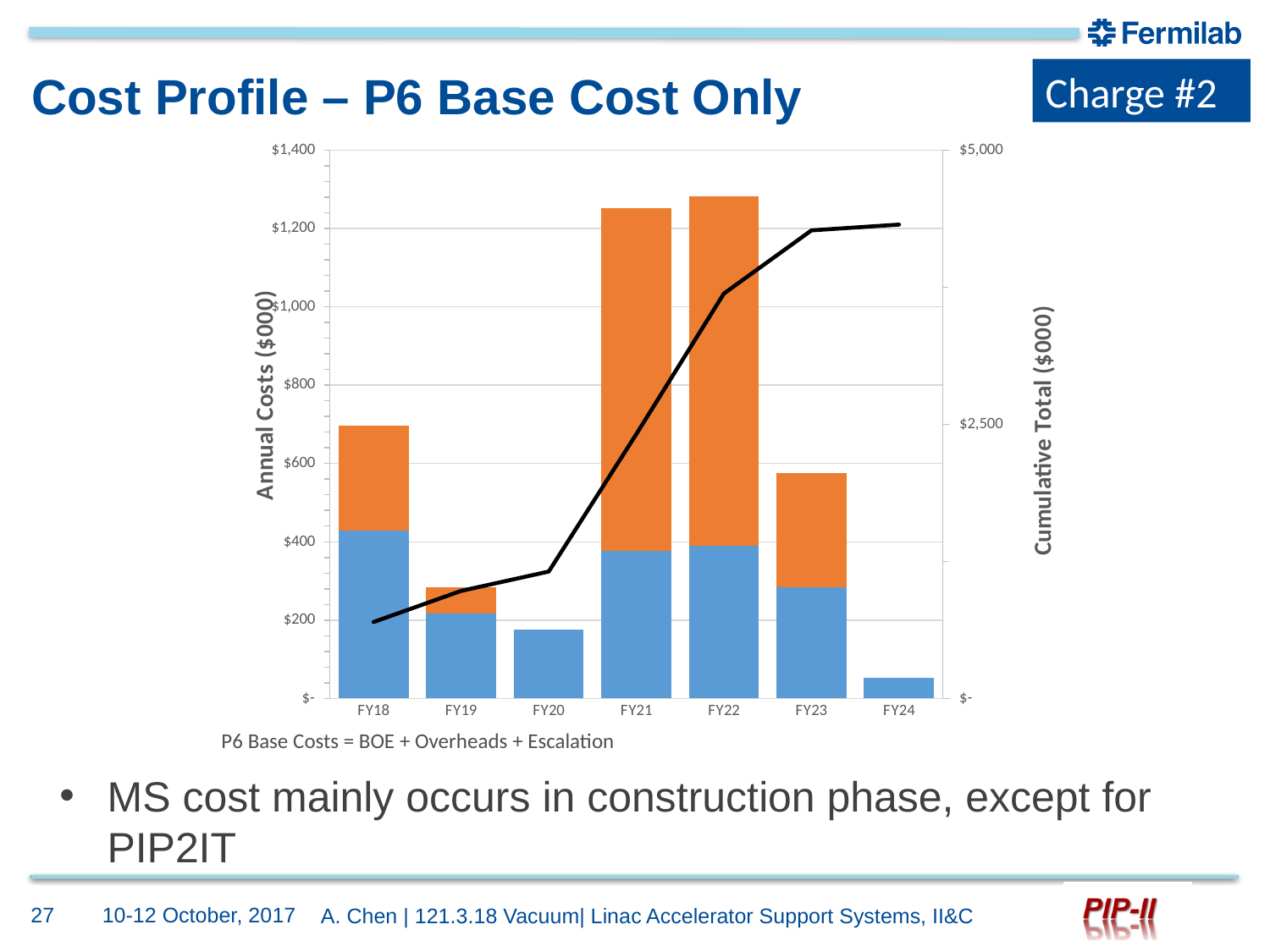
Is the cumulative total at FY24 greater or less than $2,500? greater How many fiscal years are shown on the x axis of the chart? 7 Which has the larger total annual cost bar, FY23 or FY22? FY22 Does the cumulative total line rise or fall from FY18 to FY24? rises Is the total annual cost bar for FY21 greater or less than $1,200? greater Which fiscal year has the lowest total annual cost bar? FY24 Is the total annual cost bar for FY19 greater or less than $400? less What is the title of the left vertical axis? Annual Costs ($000) Which has the larger total annual cost bar, FY18 or FY19? FY18 What kind of chart is used to show the annual costs? bar chart